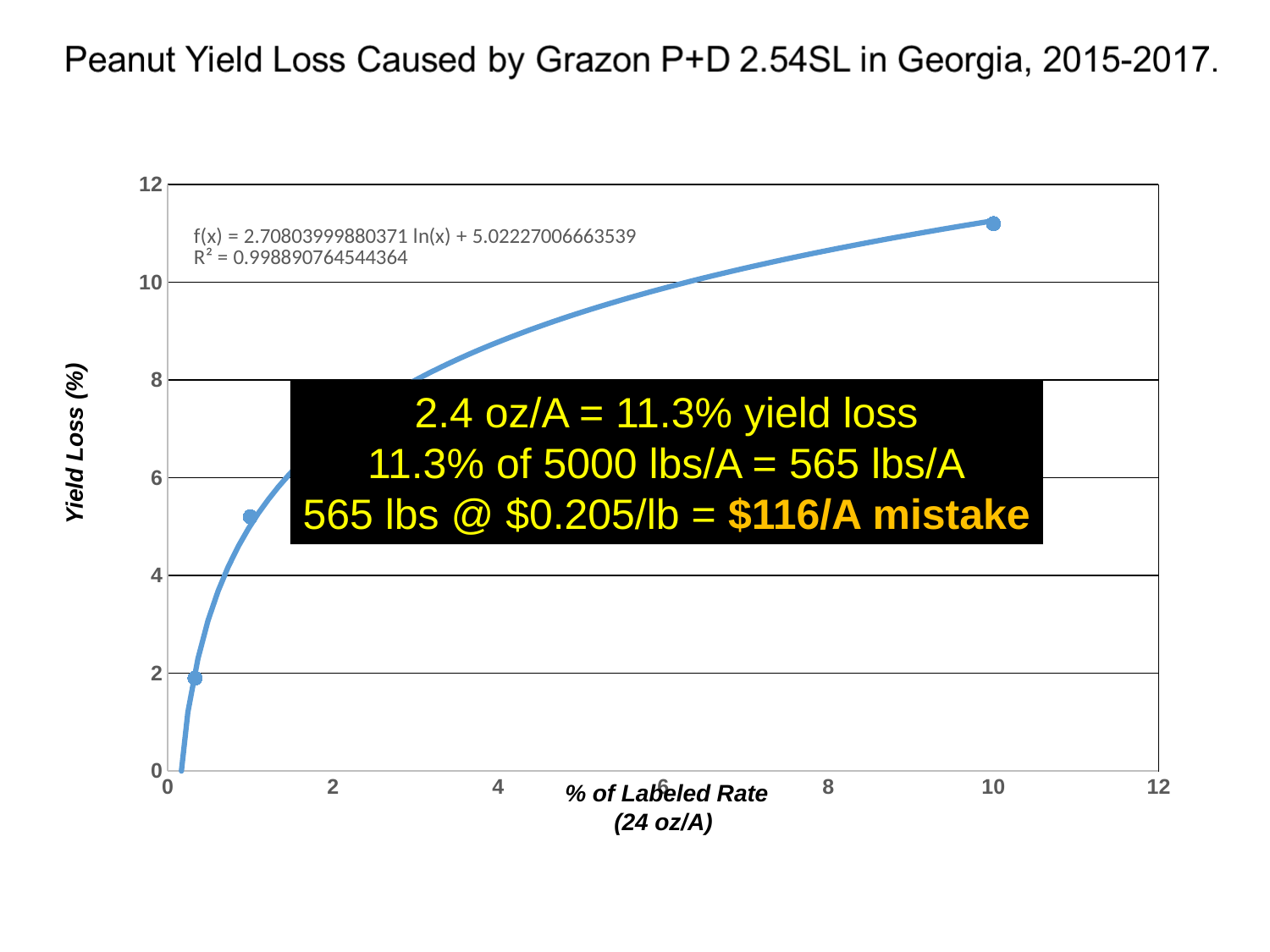
What R² value is printed on the chart for the fitted trendline? 0.998890764544364 Is the yield loss for the point at 1% of labeled rate greater or less than 6? less What is the maximum value shown on the y axis? 12 Is the yield loss for the point at 10% of labeled rate greater or less than 10? greater Is the yield loss for the leftmost plotted point greater or less than 4? less What is the title of the chart? Peanut Yield Loss Caused by Grazon P+D 2.54SL in Georgia, 2015-2017. Which plotted point has the highest yield loss: the one at 1% of labeled rate or the one at 10% of labeled rate? The one at 10% of labeled rate Does yield loss rise or fall as the % of labeled rate increases along the x axis? Rises How many data points are plotted on the chart? 3 What kind of chart is shown on the slide? Scatter chart with a fitted trendline What is the label of the y axis? Yield Loss (%)